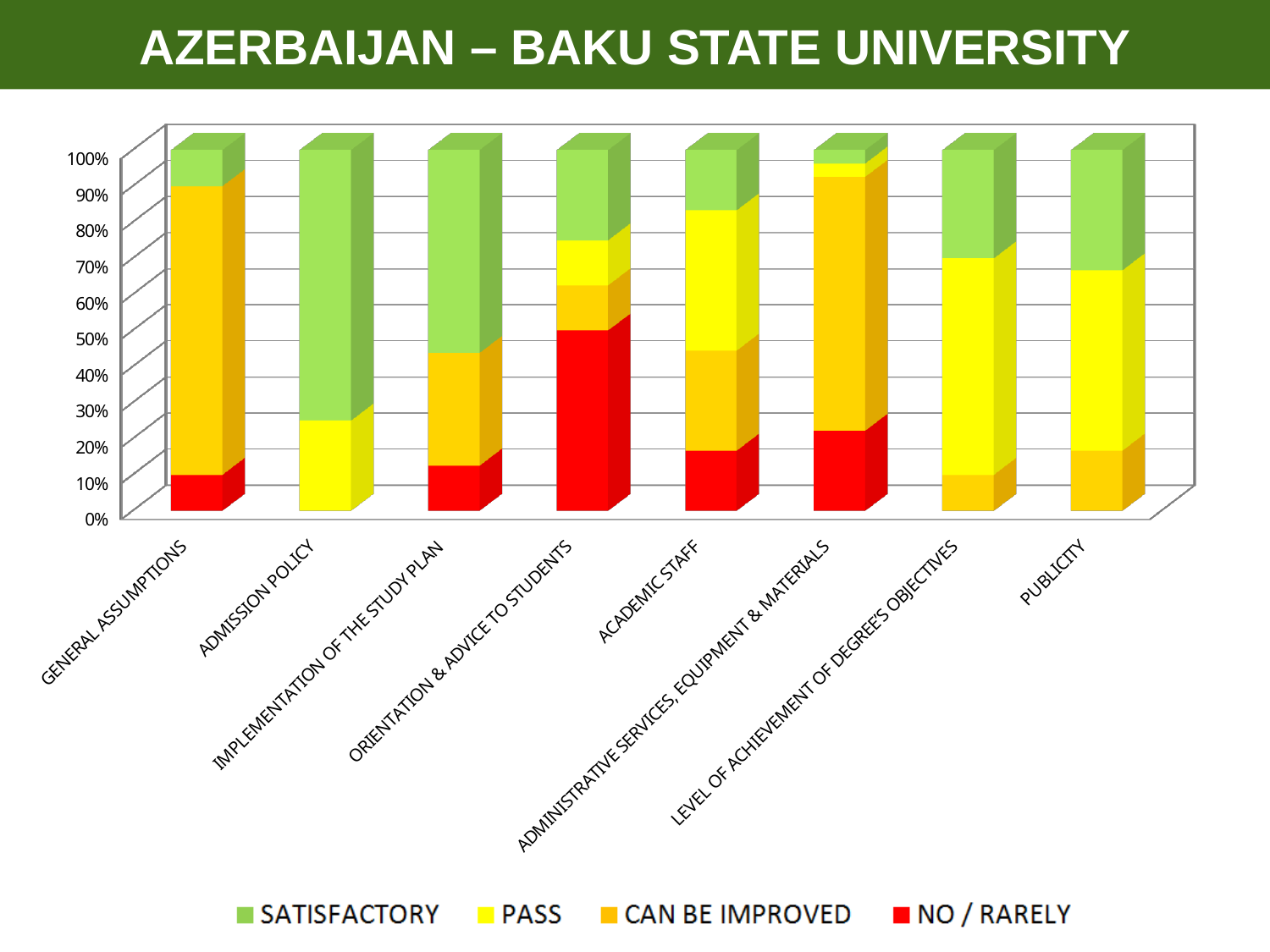
Which category has the largest SATISFACTORY share? ADMISSION POLICY What colour represents the PASS series in the legend? Yellow Is the SATISFACTORY share for ADMISSION POLICY greater or less than 60%? greater Which category has the largest NO / RARELY share? ORIENTATION & ADVICE TO STUDENTS Is the NO / RARELY share for ORIENTATION & ADVICE TO STUDENTS greater or less than 40%? greater Which category has the smallest SATISFACTORY share? ADMINISTRATIVE SERVICES, EQUIPMENT & MATERIALS Which category has the larger CAN BE IMPROVED share, GENERAL ASSUMPTIONS or ACADEMIC STAFF? GENERAL ASSUMPTIONS How many categories have no NO / RARELY segment in their bar? 3 Is the CAN BE IMPROVED share for GENERAL ASSUMPTIONS greater or less than 50%? greater What kind of chart is shown on the slide? Stacked bar chart How many categories are shown along the x axis of the chart? 8 How many series does the chart legend list? 4